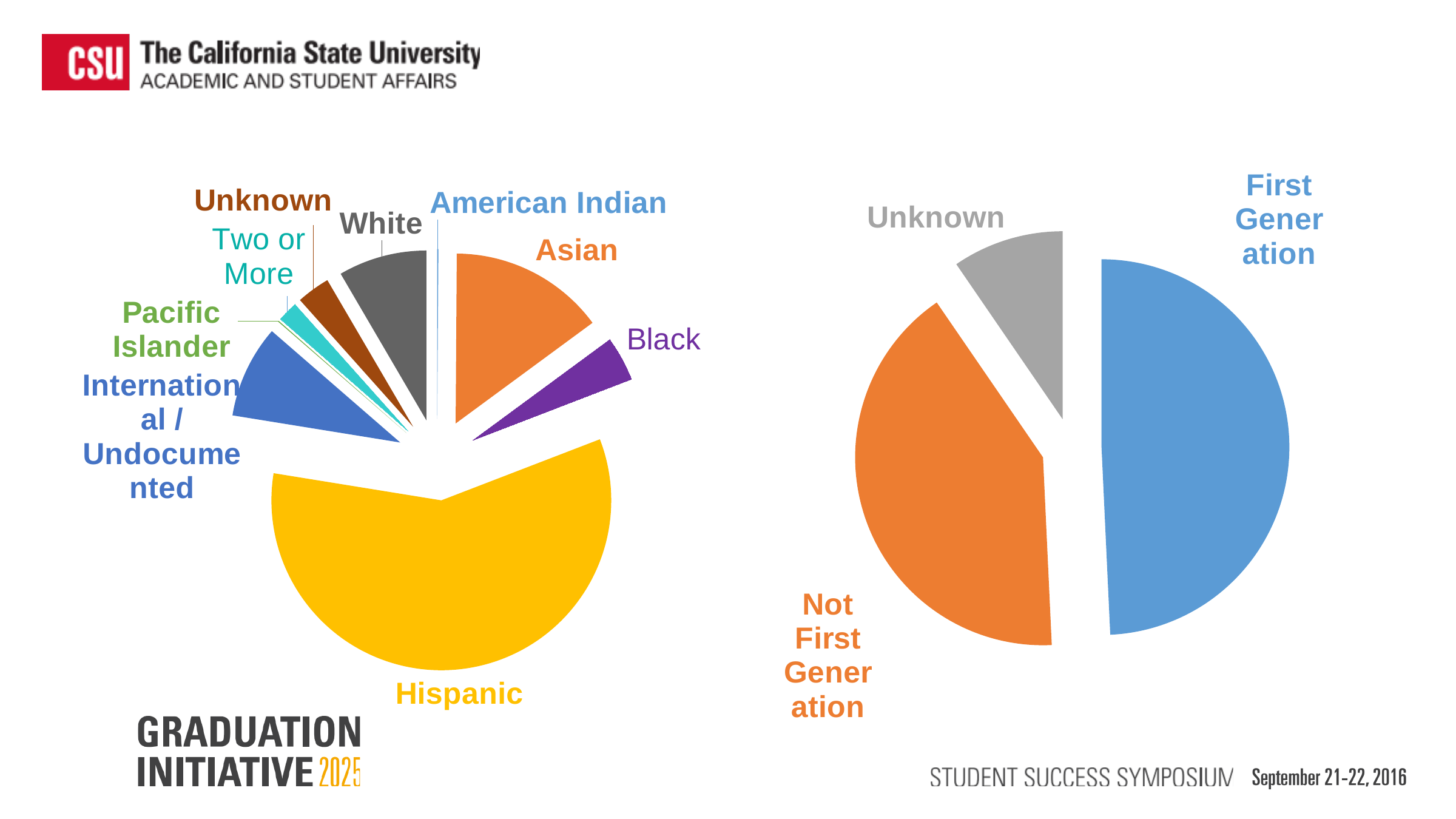
In the pie chart on the right, what colour is the First Generation slice? blue In the pie chart on the left, which slice is larger, Asian or Black? Asian In the pie chart on the right, which slice is larger, Not First Generation or Unknown? Not First Generation In the pie chart on the right, which category has the largest slice? First Generation In the pie chart on the left, how many slices (categories) are shown? 9 What kind of chart is the chart on the right side of the slide? pie chart What kind of chart is the chart on the left side of the slide? pie chart In the pie chart on the left, which category has the largest slice? Hispanic In the pie chart on the left, what colour is the Hispanic slice? yellow In the pie chart on the right, which category has the smallest slice? Unknown In the pie chart on the right, how many slices (categories) are shown? 3 In the pie chart on the left, which slice is larger, White or Unknown? White